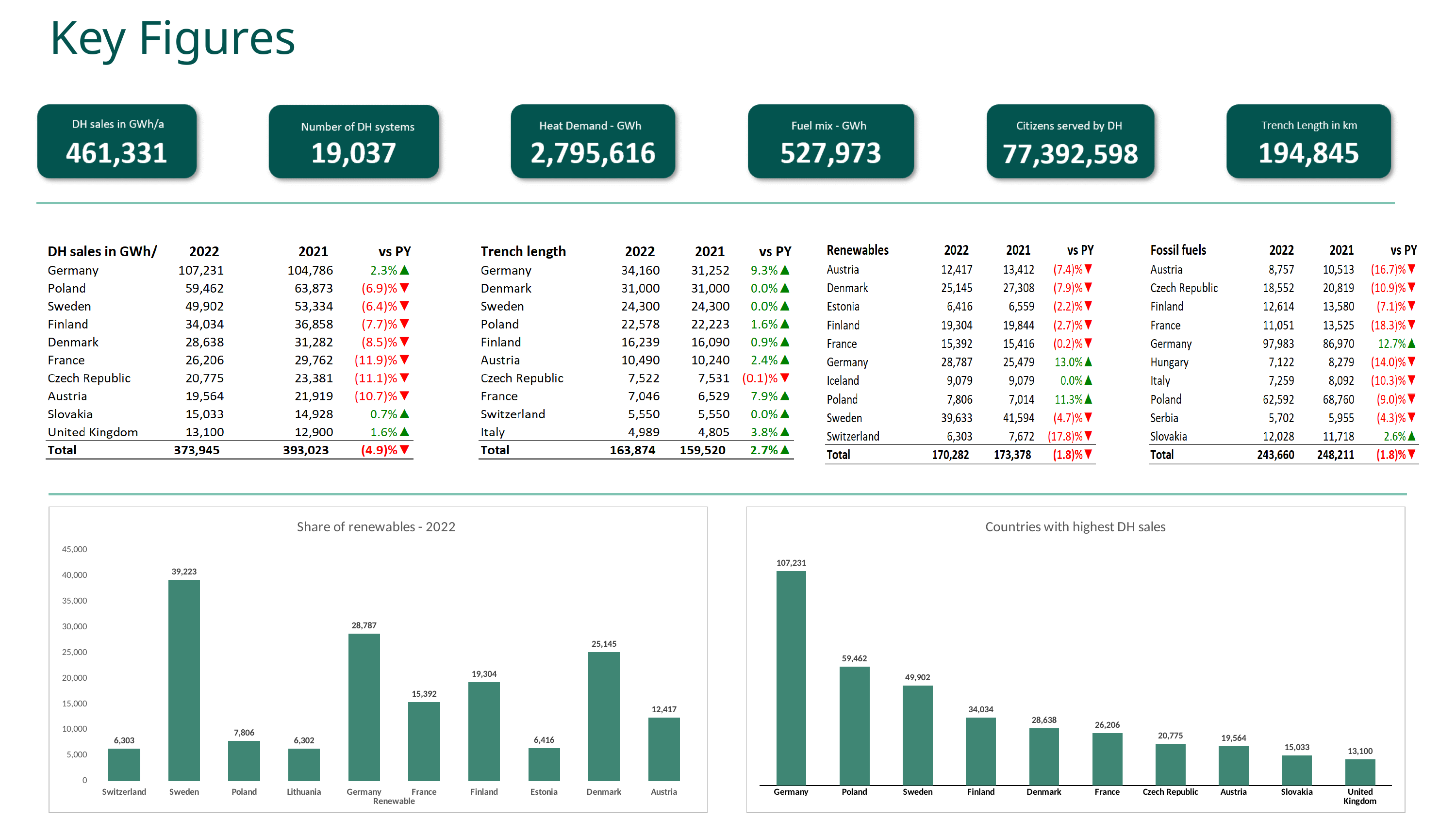
In the 'Countries with highest DH sales' chart, which country has the highest DH sales? Germany In the 'Share of renewables - 2022' chart, what is the difference between Germany and Denmark? 3,642 What type of chart is 'Countries with highest DH sales'? Bar chart In the 'Share of renewables - 2022' chart, how many countries are shown? 10 In the 'Share of renewables - 2022' chart, is the value for Finland greater or less than 20,000? less In the 'Share of renewables - 2022' chart, which country has the highest value? Sweden In the 'Share of renewables - 2022' chart, which country has the lowest value? Lithuania In the 'Countries with highest DH sales' chart, which country has the lowest value? United Kingdom In the 'Countries with highest DH sales' chart, what is the difference between Germany and Poland? 47,769 In the 'Countries with highest DH sales' chart, what is the value for Poland? 59,462 In the 'Countries with highest DH sales' chart, which is larger, Denmark or France? Denmark In the 'Share of renewables - 2022' chart, what is the value for Sweden? 39,223